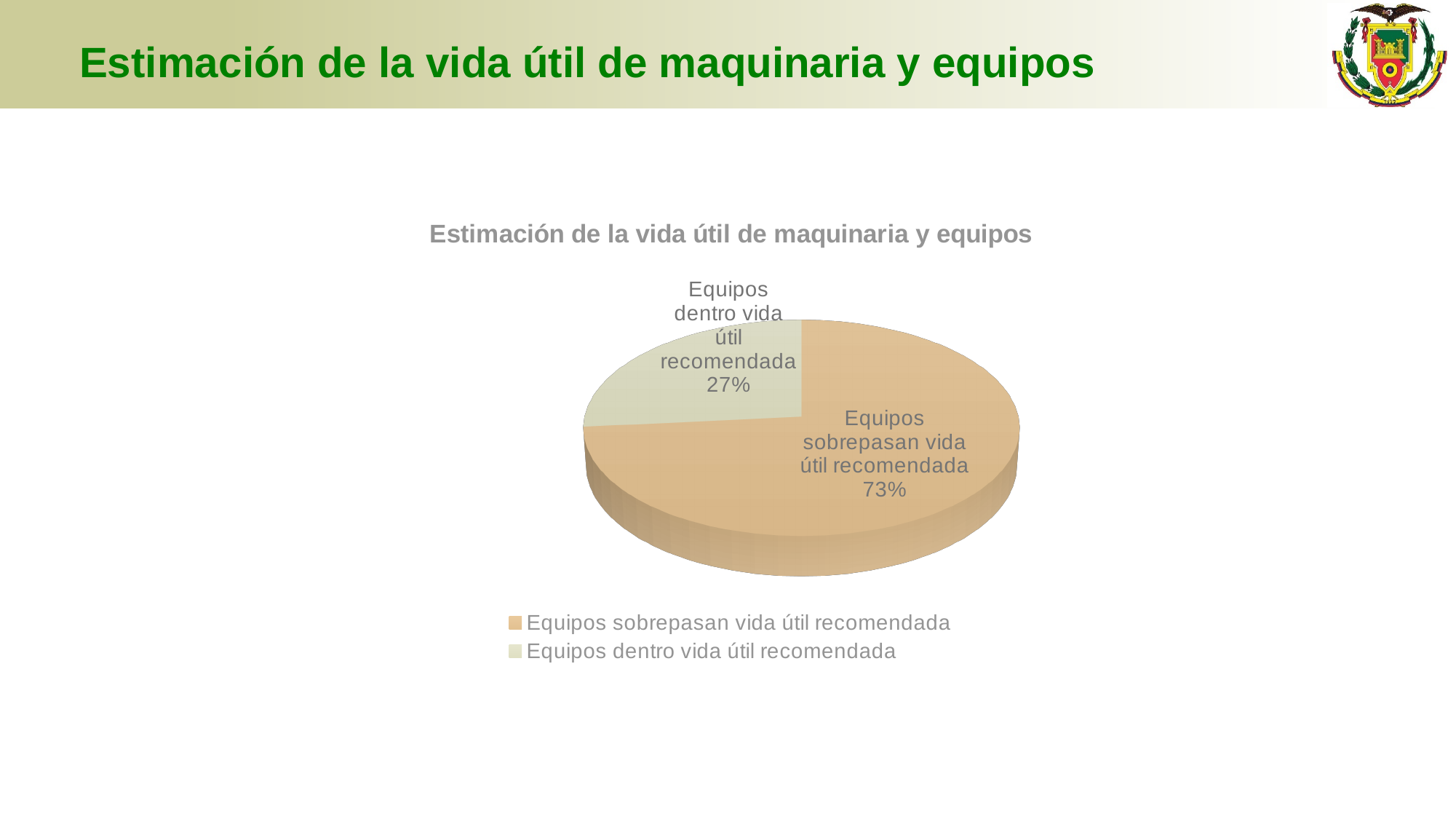
How many categories are shown in the pie chart? 2 Which is larger: the share for 'Equipos sobrepasan vida útil recomendada' or for 'Equipos dentro vida útil recomendada'? Equipos sobrepasan vida útil recomendada What is the title of the chart? Estimación de la vida útil de maquinaria y equipos What share of the pie does 'Equipos sobrepasan vida útil recomendada' represent? 73% Which category has the smallest slice of the pie? Equipos dentro vida útil recomendada How many entries does the legend list? 2 What share of the pie does 'Equipos dentro vida útil recomendada' represent? 27% Is the share for 'Equipos sobrepasan vida útil recomendada' greater or less than 50%? greater Which category has the largest slice of the pie? Equipos sobrepasan vida útil recomendada What kind of chart is shown on the slide? Pie chart What is the difference in percentage points between 'Equipos sobrepasan vida útil recomendada' and 'Equipos dentro vida útil recomendada'? 46